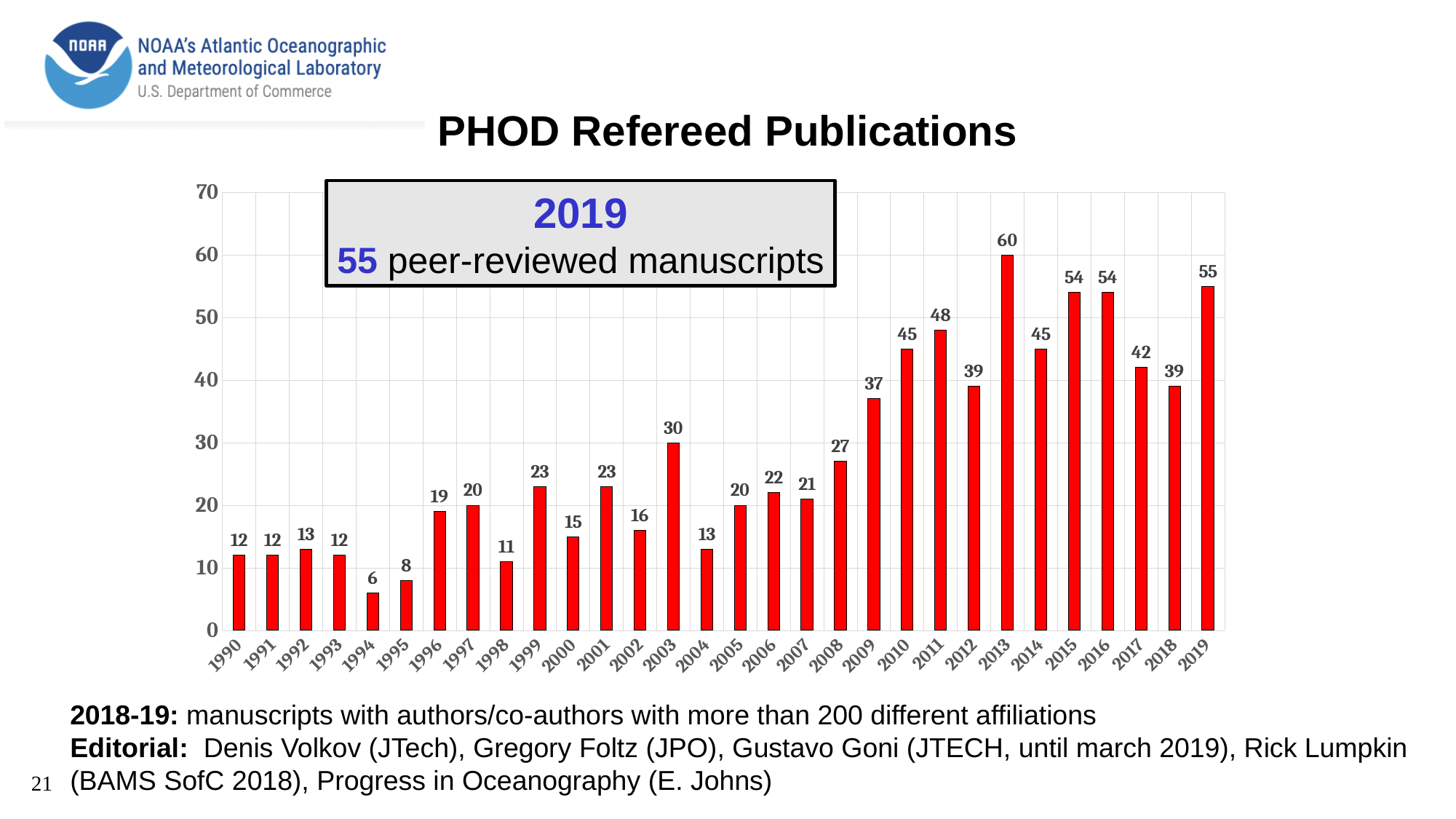
Which is larger, the value for 2017 or the value for 2018? 2017 How many years are shown on the x axis? 30 What is the value for 1994? 6 Is the value for 2011 greater or less than 40? greater Which year has the highest value? 2013 Do the values generally rise or fall from 1990 to 2019? rise What is the value for 2019? 55 Which year has the lowest value? 1994 What kind of chart is this? bar chart What is the difference between the values for 2013 and 2019? 5 What is the title of the chart? PHOD Refereed Publications What is the value for 2013? 60